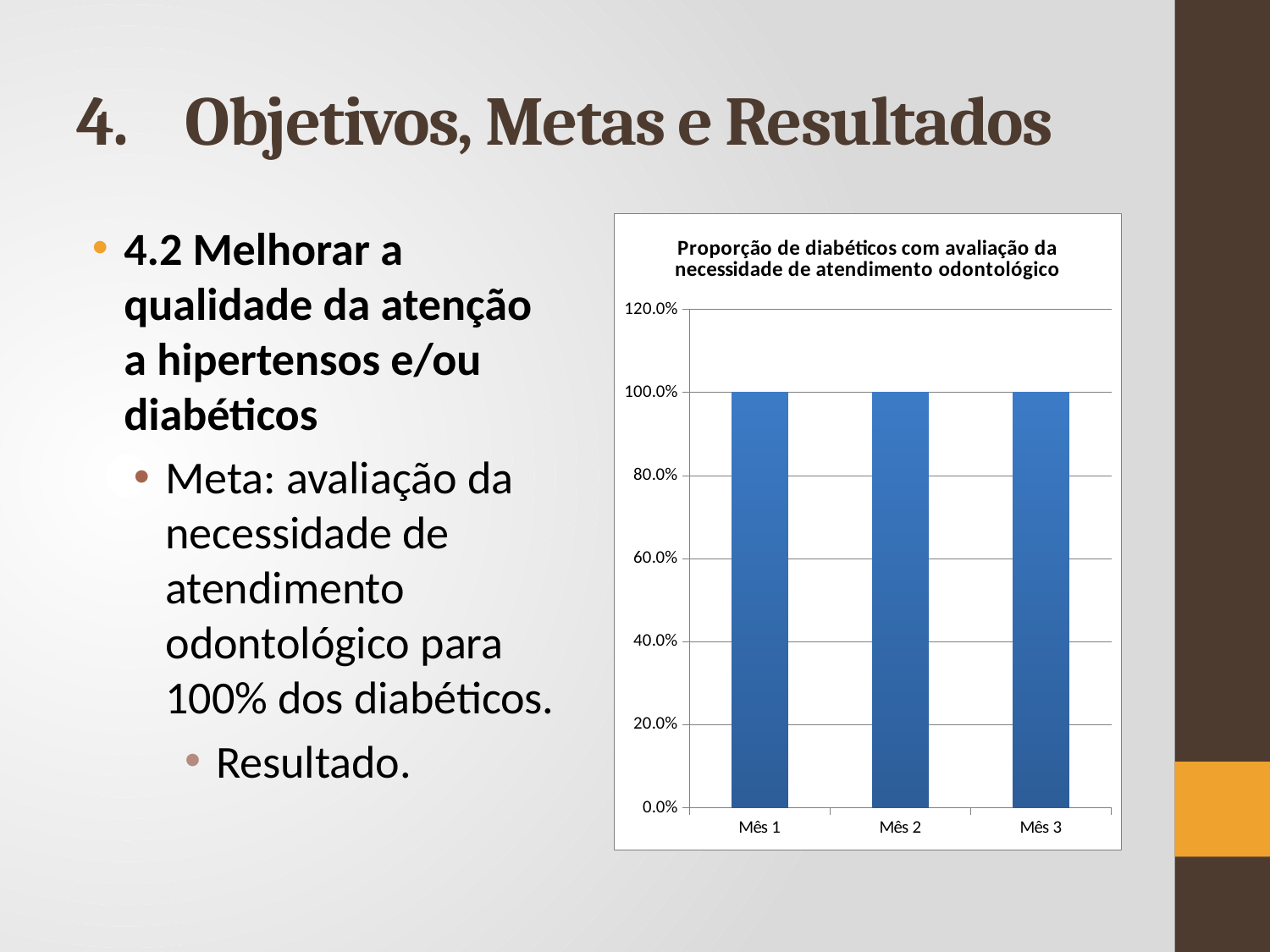
What is the highest value shown on the y axis of the chart? 120.0% Is the value for Mês 3 greater or less than 120.0%? less What is the value for Mês 3 in the chart? 100.0% How many categories (months) are shown on the x axis of the chart? 3 What is the value for Mês 2 in the chart? 100.0% Do the values rise, fall, or stay the same from Mês 1 to Mês 3? stay the same What is the title of the chart? Proporção de diabéticos com avaliação da necessidade de atendimento odontológico What is the difference between the values for Mês 1 and Mês 3? 0.0% What is the value for Mês 1 in the chart? 100.0% Is the value for Mês 2 greater or less than 80.0%? greater What type of chart is shown on the slide? bar chart